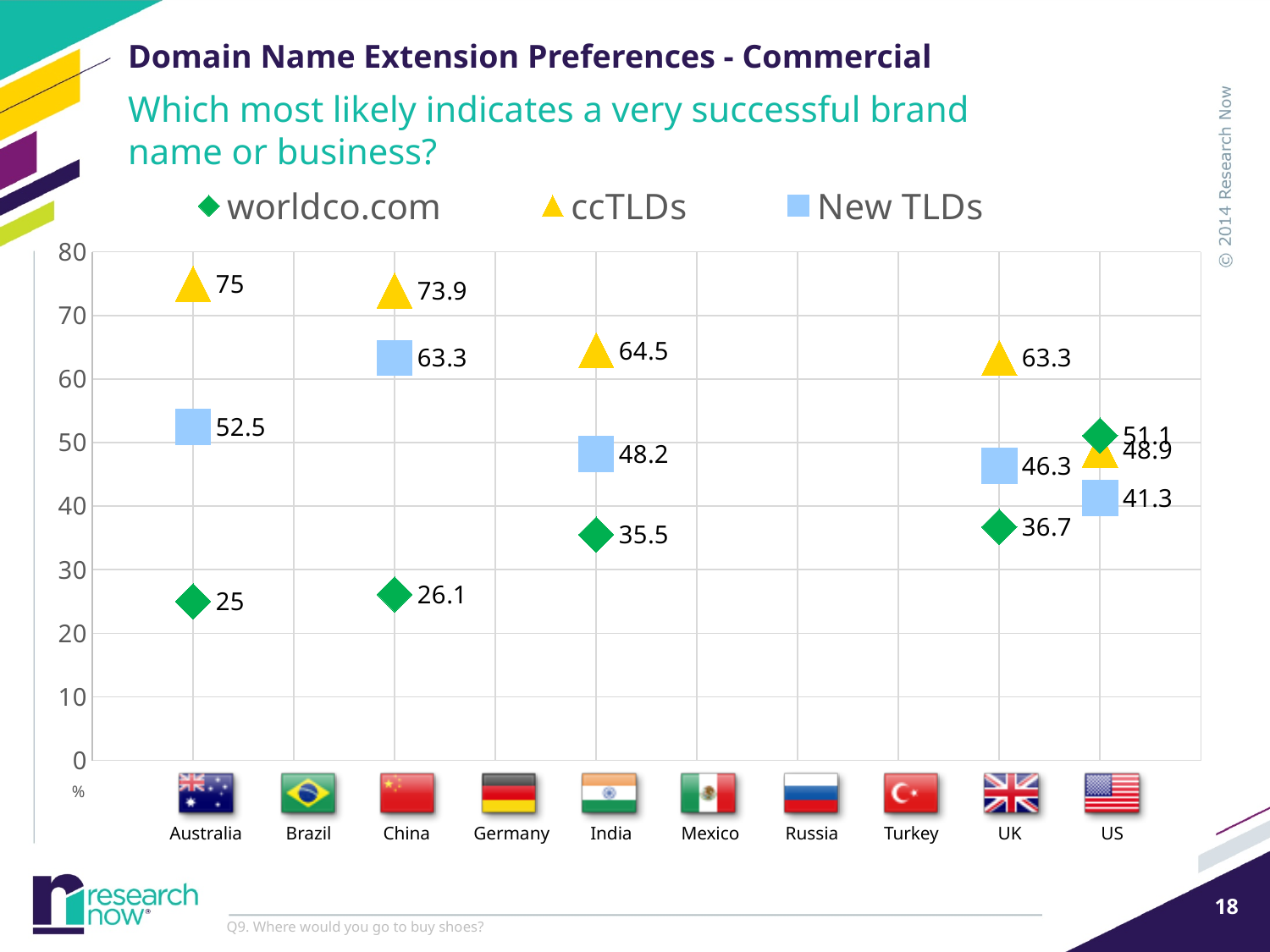
What is the difference between the ccTLDs and worldco.com values for Australia? 50 What is the difference between the ccTLDs and New TLDs values for China? 10.6 Which is larger, the New TLDs value for India or for the UK? India Which country has the highest ccTLDs value? Australia For the US, which is larger, the worldco.com value or the ccTLDs value? worldco.com Which country has the lowest worldco.com value? Australia What is the worldco.com value for the UK? 36.7 How many series does the legend list? 3 How many countries are shown along the x axis? 10 What is the New TLDs value for China? 63.3 What is the ccTLDs value for Australia? 75 What is the worldco.com value for the US? 51.1